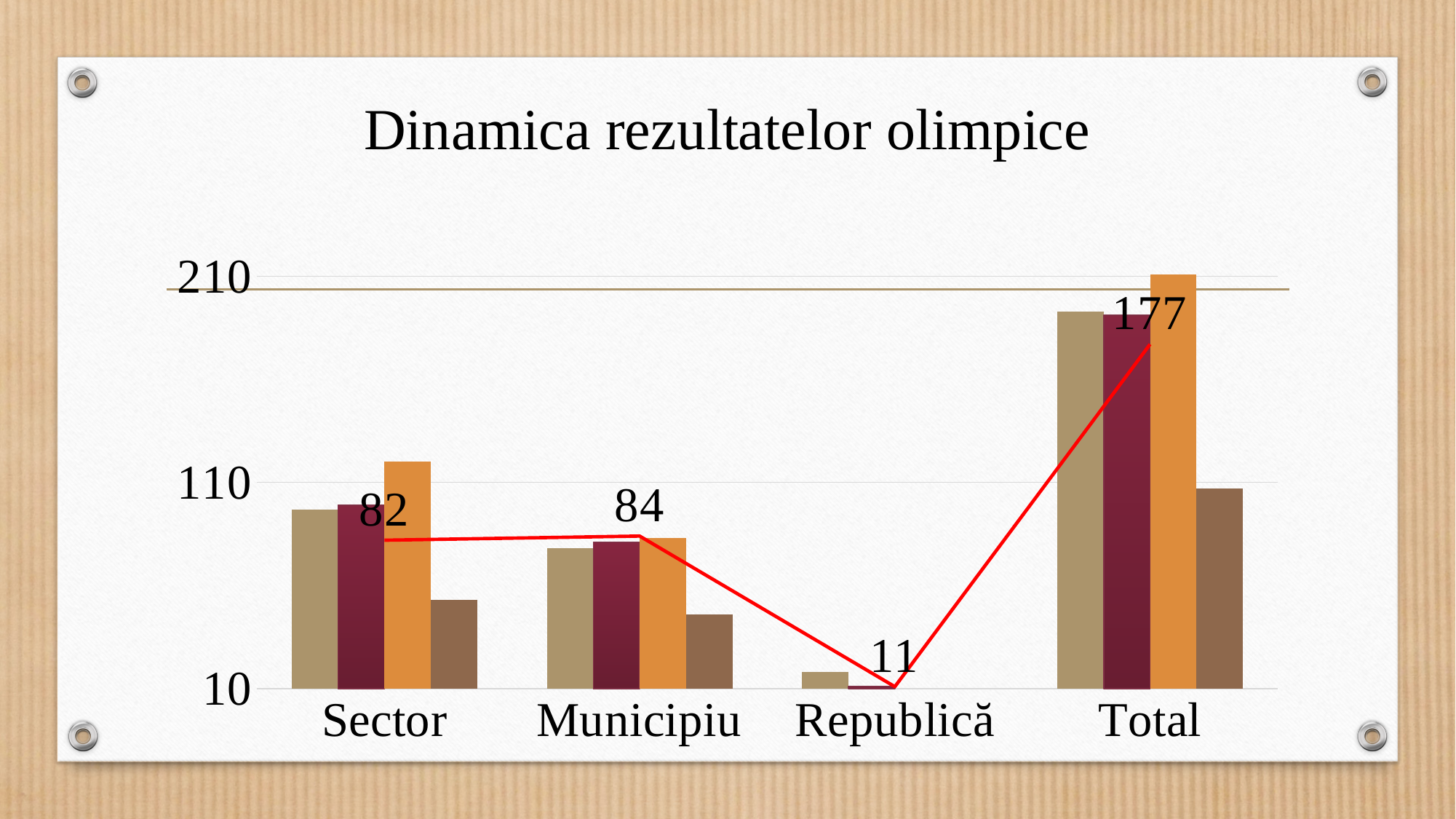
What value does the red line show for Municipiu? 84 What is the difference between the red line values for Total and Republică? 166 What value does the red line show for Sector? 82 What value does the red line show for Republică? 11 Is the orange bar for Sector greater or less than 110? greater What is the title of the chart? Dinamica rezultatelor olimpice How many categories are shown on the x axis? 4 Which category has the lowest value on the red line? Republică What value does the red line show for Total? 177 On the red line, which is larger: the value for Municipiu or the value for Sector? Municipiu What kind of chart is shown on the slide? Bar chart with a line Which category has the highest value on the red line? Total